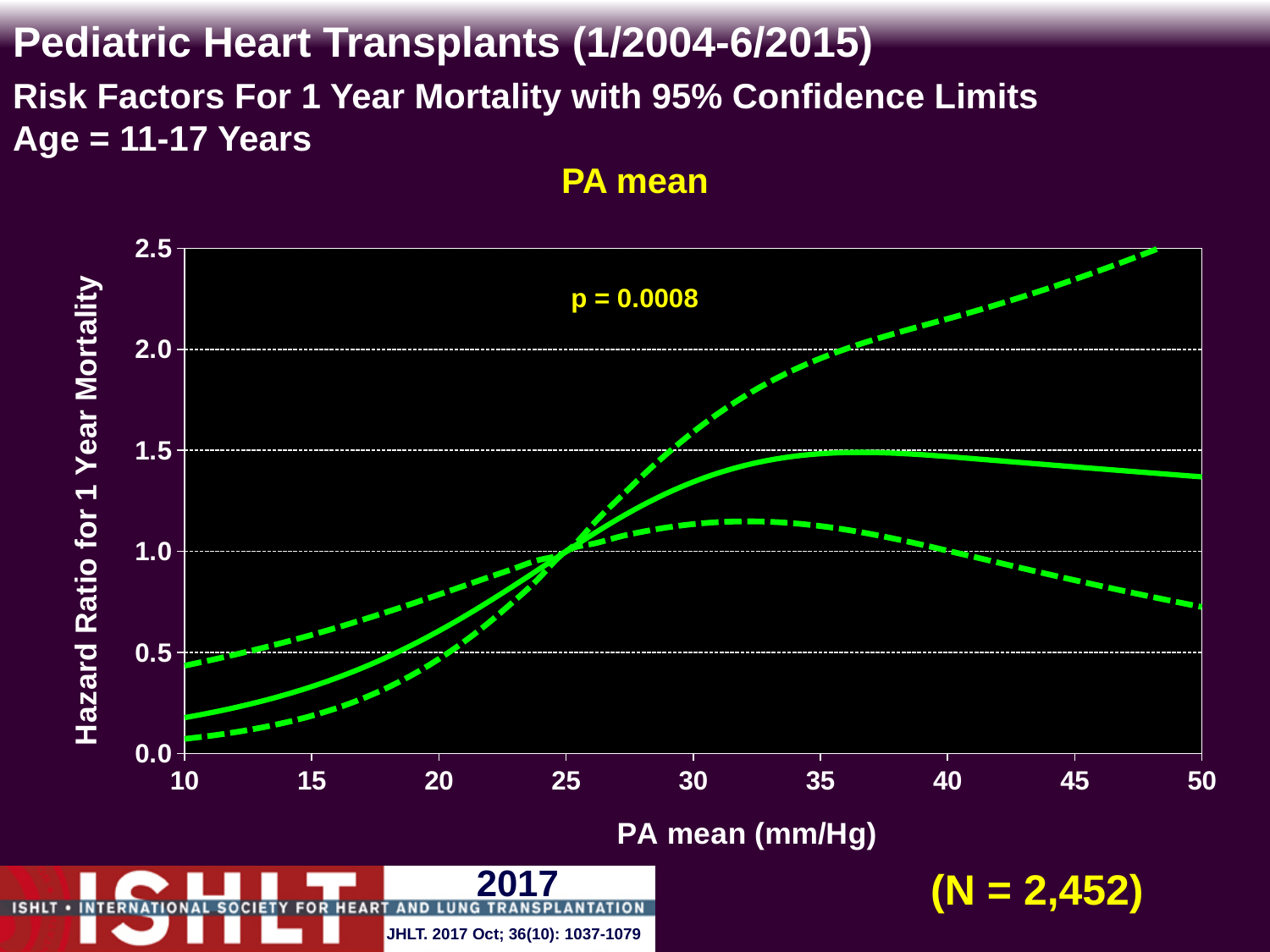
Does the solid hazard ratio line rise or fall as PA mean increases from 10 to 30 mm/Hg? rise What p-value is printed on the chart? p = 0.0008 What is the sample size N shown on the slide? N = 2,452 Is the solid hazard ratio line at a PA mean of 10 mm/Hg greater or less than 0.5? less At a PA mean of 50 mm/Hg, which dashed confidence limit is higher, the upper or the lower? upper Is the lower dashed confidence limit at a PA mean of 50 mm/Hg greater or less than 1.0? less What kind of chart is shown on the slide? line chart Is the lower dashed confidence limit at a PA mean of 15 mm/Hg greater or less than 0.5? less How many lines are plotted on the chart? 3 Is the solid hazard ratio line higher at a PA mean of 50 mm/Hg or at a PA mean of 10 mm/Hg? 50 mm/Hg